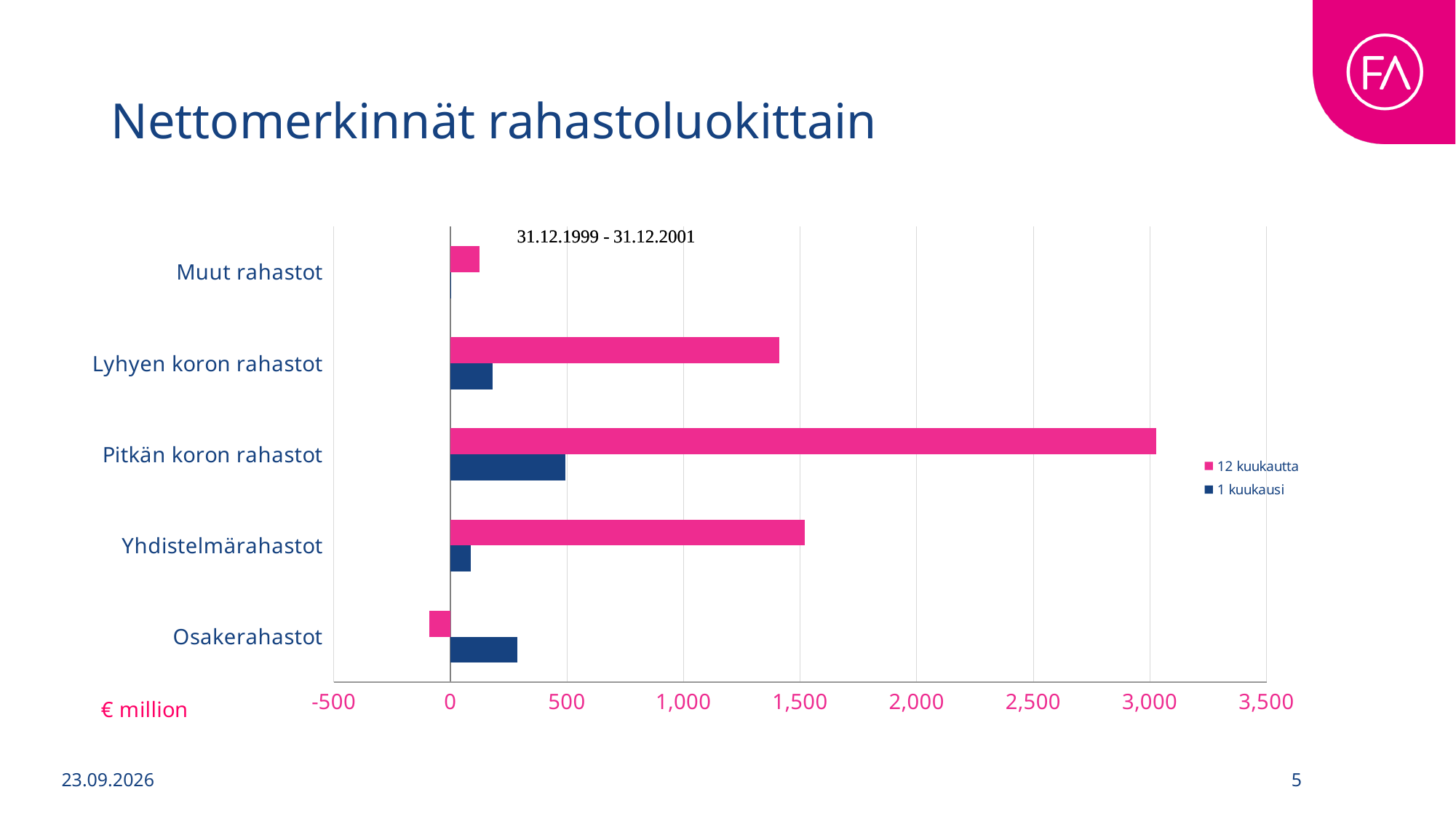
How many fund categories are shown on the chart? 5 Is the 12 kuukautta value for Pitkän koron rahastot greater or less than 2,500? greater For the 1 kuukausi series, which is larger: Osakerahastot or Lyhyen koron rahastot? Osakerahastot How many series does the legend list? 2 Is the 12 kuukautta value for Osakerahastot greater or less than 0? less Is the 1 kuukausi value for Pitkän koron rahastot greater or less than 1,000? less Which category has the highest value for the 12 kuukautta series? Pitkän koron rahastot Which category has the highest value for the 1 kuukausi series? Pitkän koron rahastot Which category has the lowest value for the 12 kuukautta series? Osakerahastot What unit is shown for the x axis of the chart? € million What kind of chart is shown on the slide? bar chart